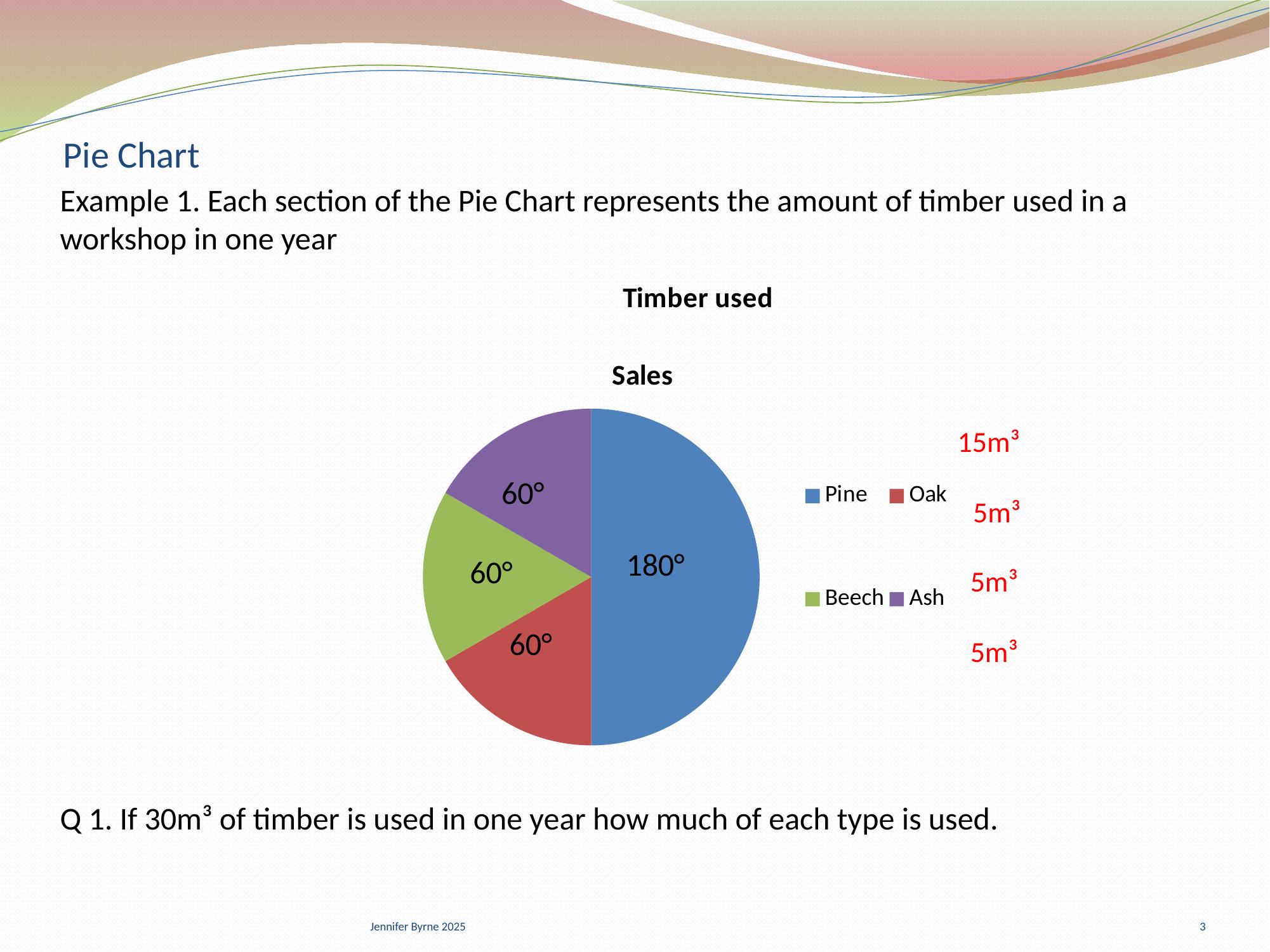
What colour is the Pine slice in the pie chart? blue What share of the whole pie does the Pine slice represent? 50% How many slices does the pie chart have? 4 Which timber type has the largest slice in the pie chart? Pine What is the difference in degrees between the Pine slice and the Oak slice? 120° What angle is labelled on the Ash slice of the pie chart? 60° What angle is labelled on the Beech slice of the pie chart? 60° What angle is labelled on the Pine slice of the pie chart? 180° What angle is labelled on the Oak slice of the pie chart? 60° Which slice is larger, Pine or Ash? Pine What is the title of the chart? Sales What kind of chart is shown on the slide? pie chart